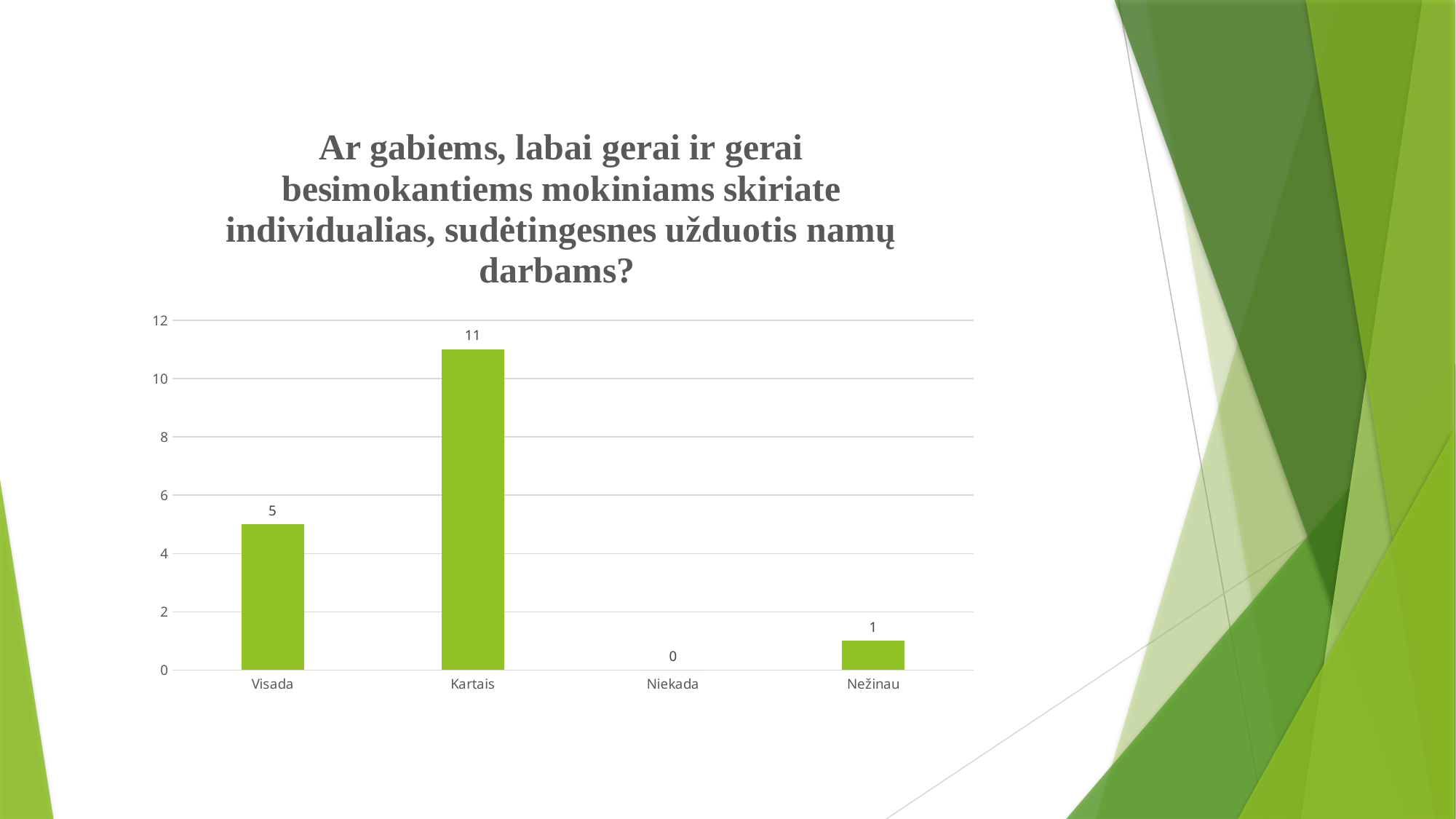
Which is larger, the value for Visada or the value for Nežinau? Visada What is the value for Kartais? 11 What is the value for Nežinau? 1 Is the value for Kartais greater or less than 10? greater Which category has the lowest value? Niekada What is the value for Visada? 5 What is the difference between the values for Kartais and Visada? 6 What kind of chart is shown on the slide? bar chart How many categories are shown on the x axis? 4 What colour are the bars in the chart? green Which category has the highest value? Kartais What is the value for Niekada? 0